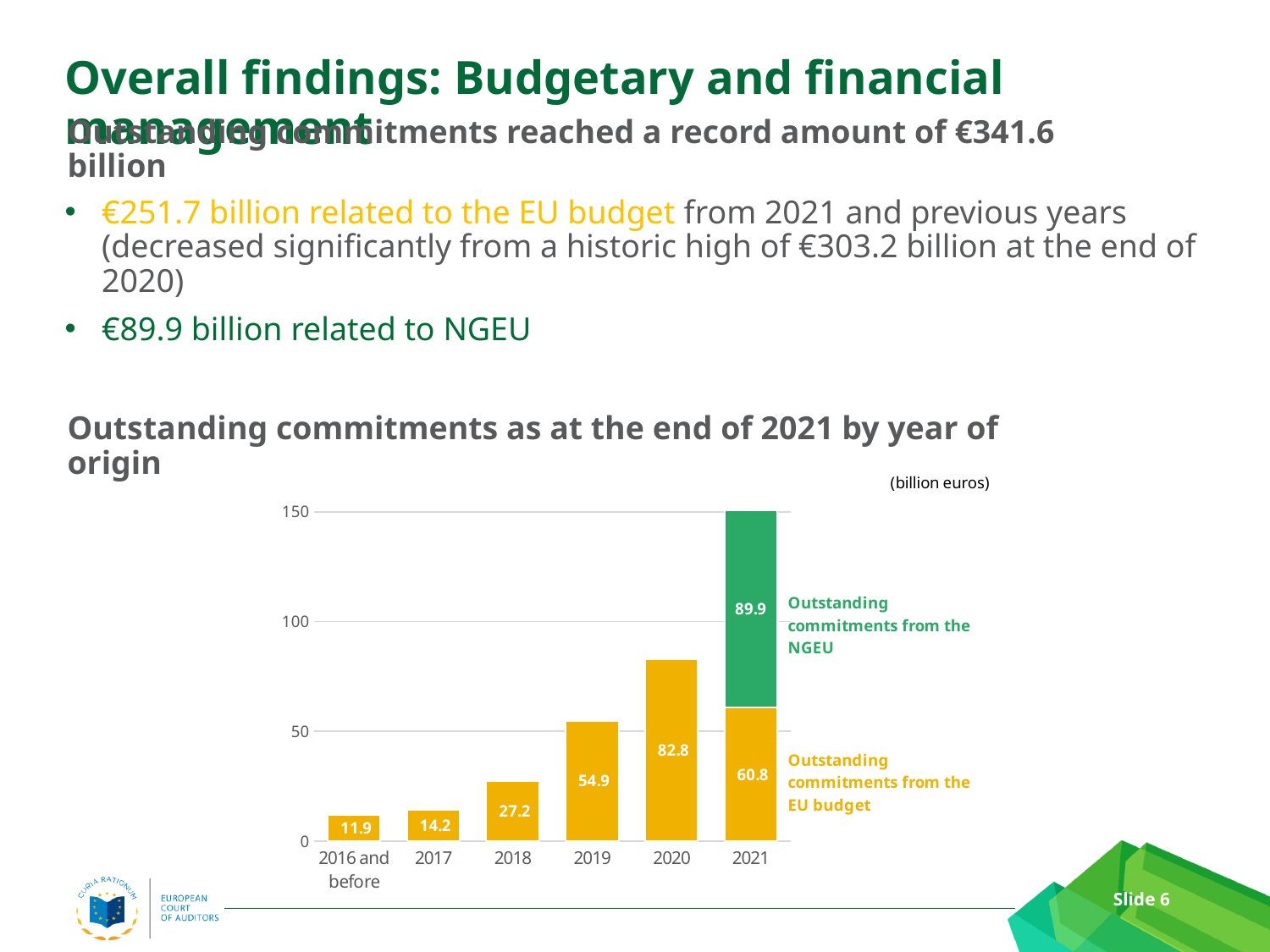
Which is larger, the EU budget outstanding commitments for 2018 or for 2017? 2018 How many series does the chart show? 2 What kind of chart is shown on the slide? Stacked bar chart What unit is indicated for the chart values? billion euros What is the value of outstanding commitments from the EU budget for 2016 and before? 11.9 What is the difference between the EU budget outstanding commitments for 2020 and 2019? 27.9 Which category has the lowest outstanding commitments from the EU budget? 2016 and before Which year has the highest outstanding commitments from the EU budget? 2020 What is the value of outstanding commitments from the EU budget for 2019? 54.9 What is the total of the stacked bar for 2021? 150.7 What is the value of outstanding commitments from the NGEU for 2021? 89.9 How many year categories are shown on the x axis? 6